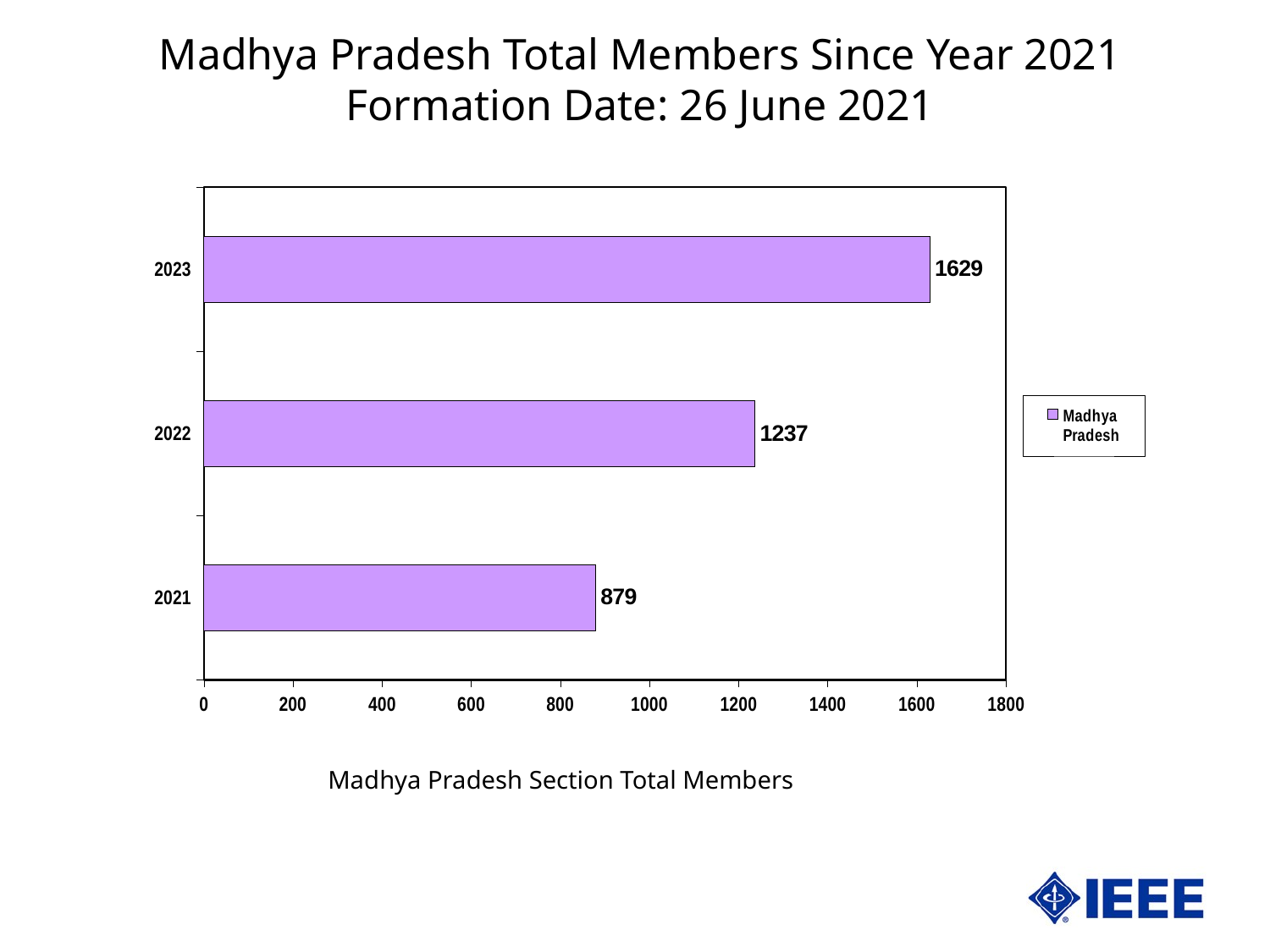
What kind of chart is shown? bar chart What is the difference between the values for 2022 and 2021? 358 What is the difference between the values for 2023 and 2022? 392 What is the value for 2023? 1629 How many years are shown in the chart? 3 Which year has the lowest value? 2021 Which year has the highest value? 2023 What is the value for 2022? 1237 Is the value for 2021 greater or less than 1000? less What series name does the legend list? Madhya Pradesh What is the value for 2021? 879 Which is larger, the value for 2022 or the value for 2021? 2022